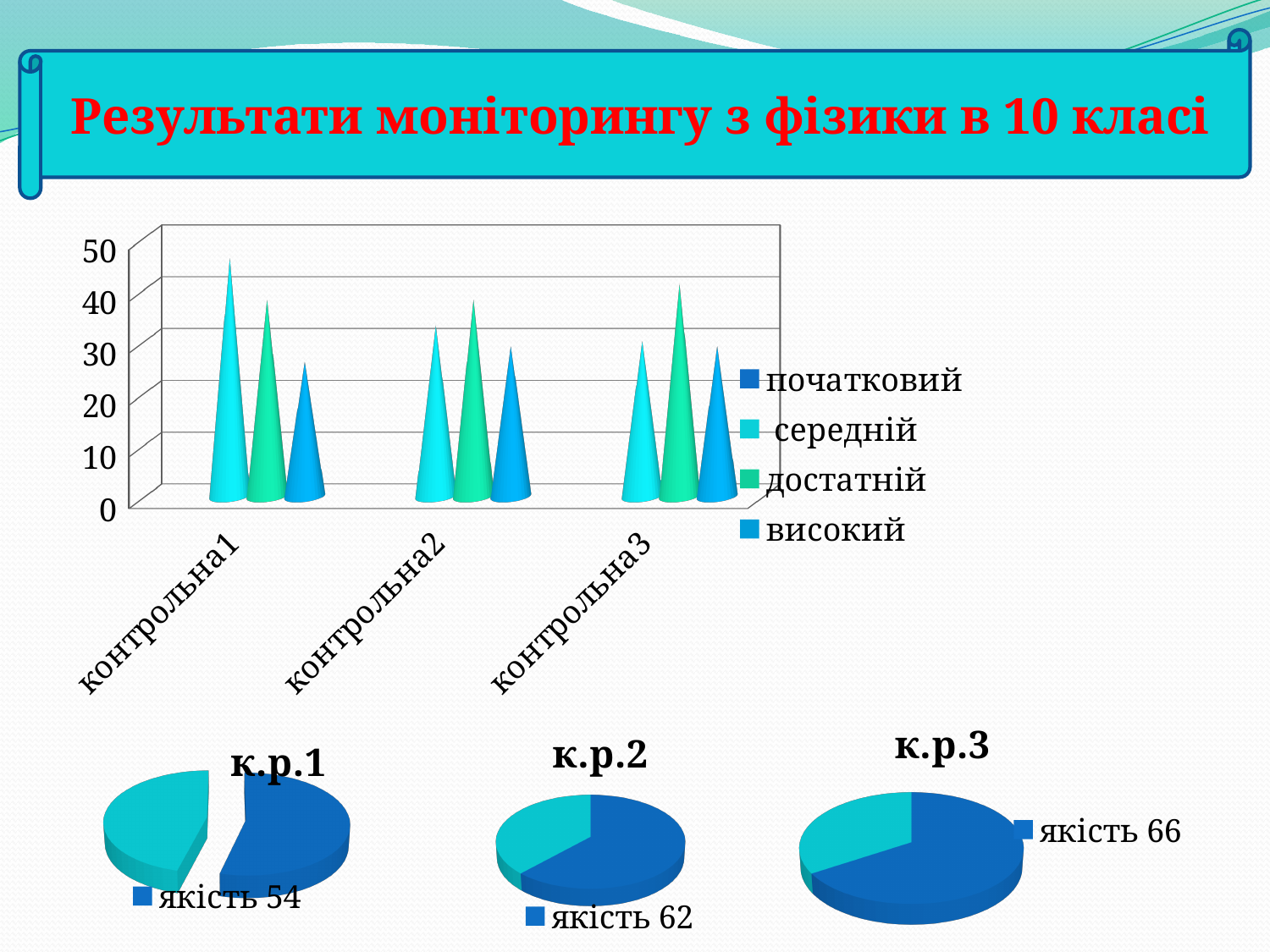
In the top chart, is the value of достатній for контрольна3 greater or less than 30? greater How many series does the legend of the top chart list? 4 In the top chart, is the value of середній for контрольна1 greater or less than 40? greater In the top chart, which series has the highest value for контрольна3? достатній In the top chart, which is larger for контрольна1: середній or високий? середній In the top chart, which series has the highest value for контрольна1? середній How many categories does the top chart show on its x axis? 3 What is the difference between the якість values of the pie charts к.р.3 and к.р.1? 12 What kind of chart is the top chart on the slide? bar chart In the top chart, does the value of середній rise or fall from контрольна1 to контрольна3? fall In the top chart, is the value of високий for контрольна1 greater or less than 30? less What is the якість value shown in the legend of the pie chart titled к.р.2? 62